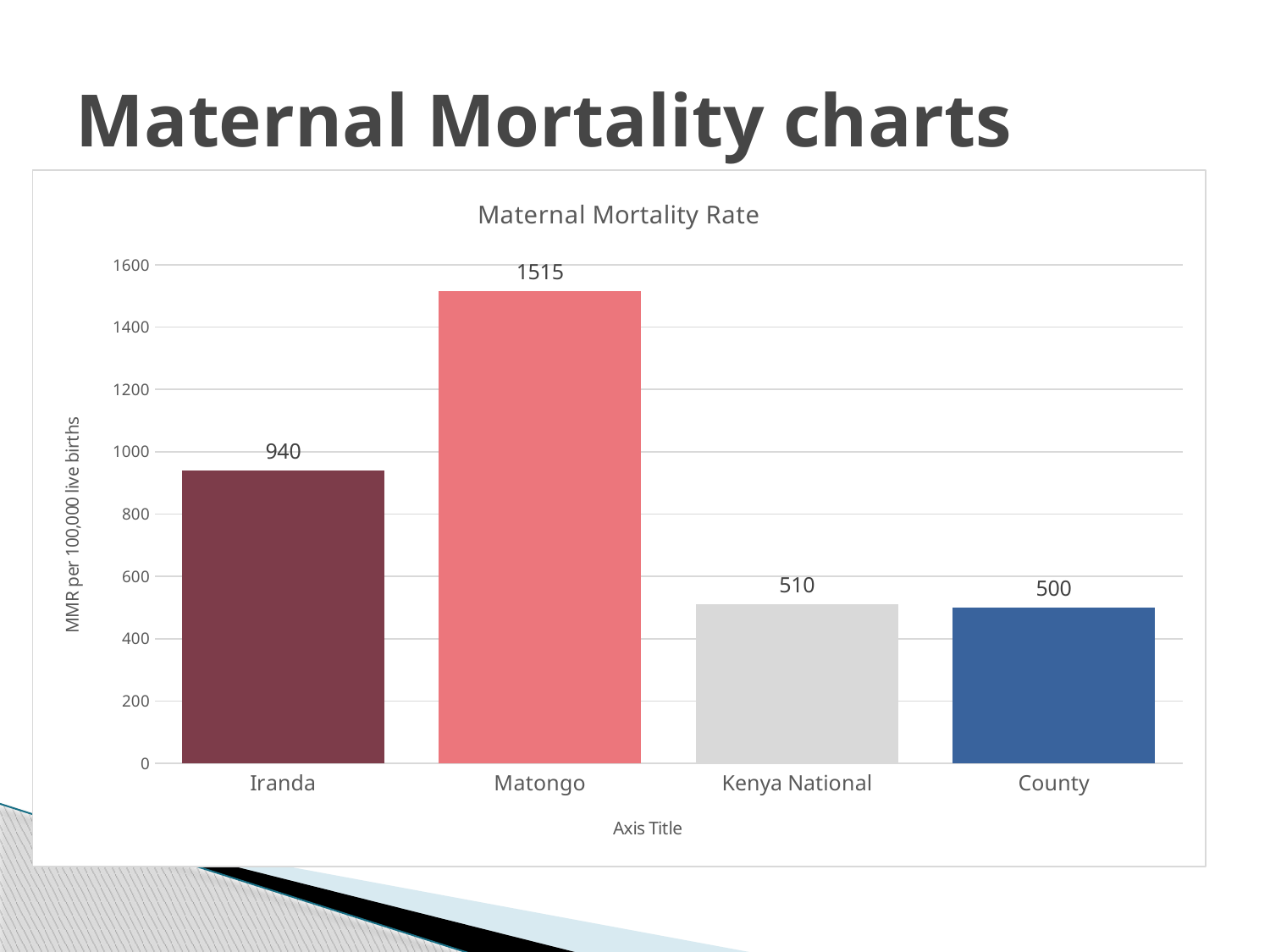
What kind of chart is shown on the slide? Bar chart How many categories are shown in the Maternal Mortality Rate chart? 4 Which has a higher Maternal Mortality Rate, Iranda or Kenya National? Iranda What is the Maternal Mortality Rate for Iranda? 940 What is the difference between the Maternal Mortality Rate for Iranda and Kenya National? 430 What is the Maternal Mortality Rate for Kenya National? 510 What is the label of the vertical axis of the chart? MMR per 100,000 live births Which category has the lowest Maternal Mortality Rate? County Which category has the highest Maternal Mortality Rate? Matongo What is the Maternal Mortality Rate for County? 500 What is the difference between the Maternal Mortality Rate for Matongo and Iranda? 575 What is the Maternal Mortality Rate for Matongo? 1515